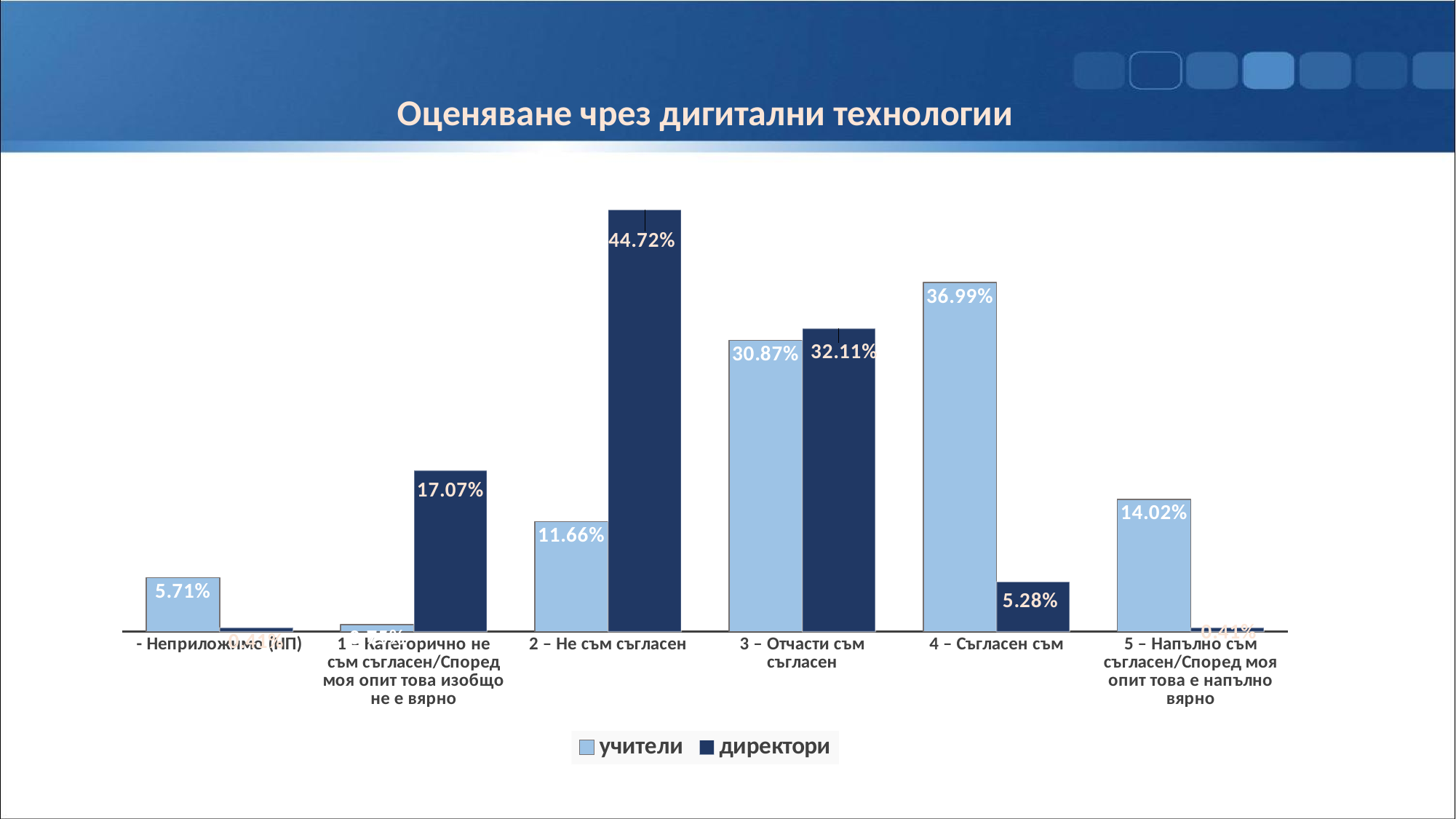
Which category has the highest value for директори? 2 – Не съм съгласен What is the value for директори in the category "1 – Категорично не съм съгласен/Според моя опит това изобщо не е вярно"? 17.07% Which category has the highest value for учители? 4 – Съгласен съм What is the title of the chart? Оценяване чрез дигитални технологии What is the difference between the директори and учители values in the category "2 – Не съм съгласен"? 33.06% How many series does the legend list? 2 What is the value for директори in the category "2 – Не съм съгласен"? 44.72% What is the value for учители in the category "4 – Съгласен съм"? 36.99% What is the value for учители in the category "3 – Отчасти съм съгласен"? 30.87% What type of chart is shown on the slide? bar chart In the category "4 – Съгласен съм", which series has the larger value, учители or директори? учители How many categories are shown on the x axis? 6